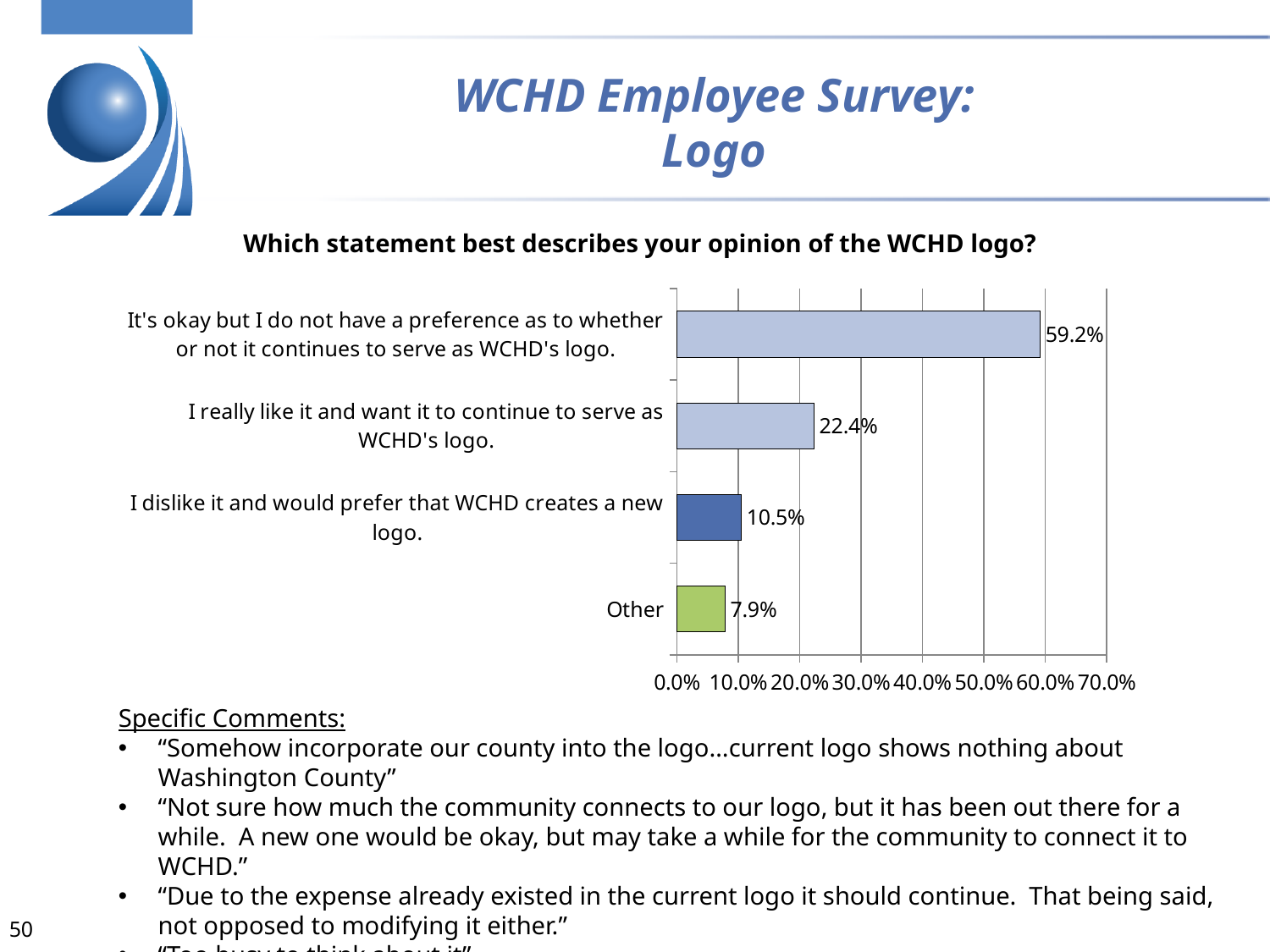
Which is larger: the percentage for "I dislike it and would prefer that WCHD creates a new logo" or for "Other"? I dislike it and would prefer that WCHD creates a new logo. What percentage of respondents said "I really like it and want it to continue to serve as WCHD's logo"? 22.4% What percentage of respondents said "It's okay but I do not have a preference as to whether or not it continues to serve as WCHD's logo"? 59.2% What percentage of respondents said "I dislike it and would prefer that WCHD creates a new logo"? 10.5% What is the difference in percentage points between "It's okay but I do not have a preference..." and "I really like it and want it to continue..."? 36.8 Which response category has the lowest percentage? Other Which response category has the highest percentage? It's okay but I do not have a preference as to whether or not it continues to serve as WCHD's logo. What percentage of respondents chose "Other"? 7.9% Is the value for "I really like it and want it to continue to serve as WCHD's logo" greater or less than 30.0%? less What type of chart is shown on the slide? Bar chart How many response categories are shown in the chart? 4 What is the survey question shown above the chart? Which statement best describes your opinion of the WCHD logo?